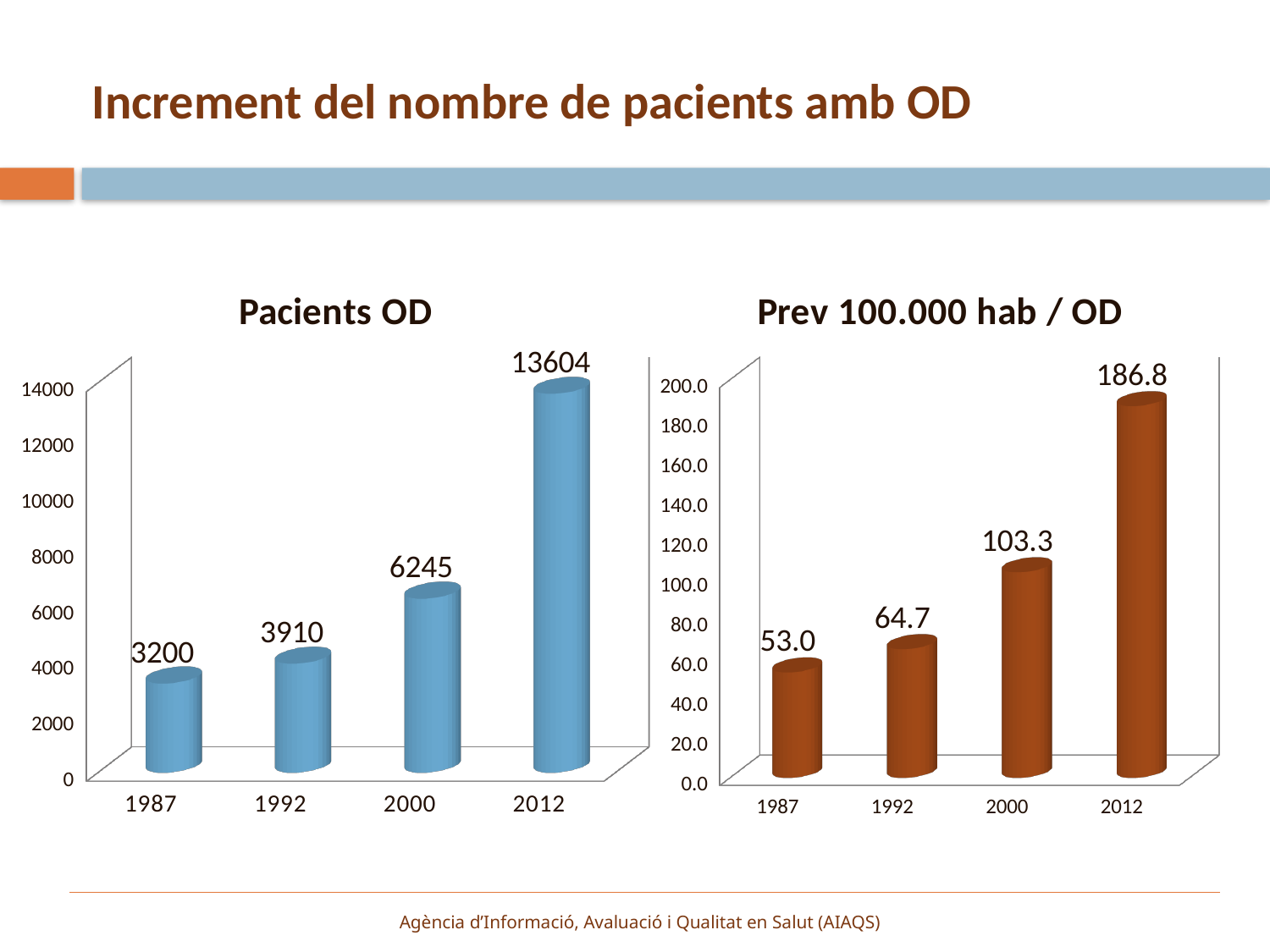
In the 'Prev 100.000 hab / OD' chart, what is the difference between the values for 2000 and 1987? 50.3 In the 'Pacients OD' chart, which is larger, the value for 1992 or the value for 1987? 1992 In the 'Prev 100.000 hab / OD' chart, what is the value for 1992? 64.7 In the 'Pacients OD' chart, what is the value for 2000? 6245 How many years are shown on the x axis of the 'Pacients OD' chart? 4 In the 'Pacients OD' chart, what is the difference between the values for 2012 and 2000? 7359 In the 'Pacients OD' chart, which year has the highest value? 2012 In the 'Prev 100.000 hab / OD' chart, which year has the lowest value? 1987 In the 'Pacients OD' chart, do the values rise or fall from 1987 to 2012? rise What kind of chart is the 'Prev 100.000 hab / OD' chart? bar chart What is the title of the chart on the right side of the slide? Prev 100.000 hab / OD In the 'Prev 100.000 hab / OD' chart, is the value for 2012 greater or less than 180.0? greater